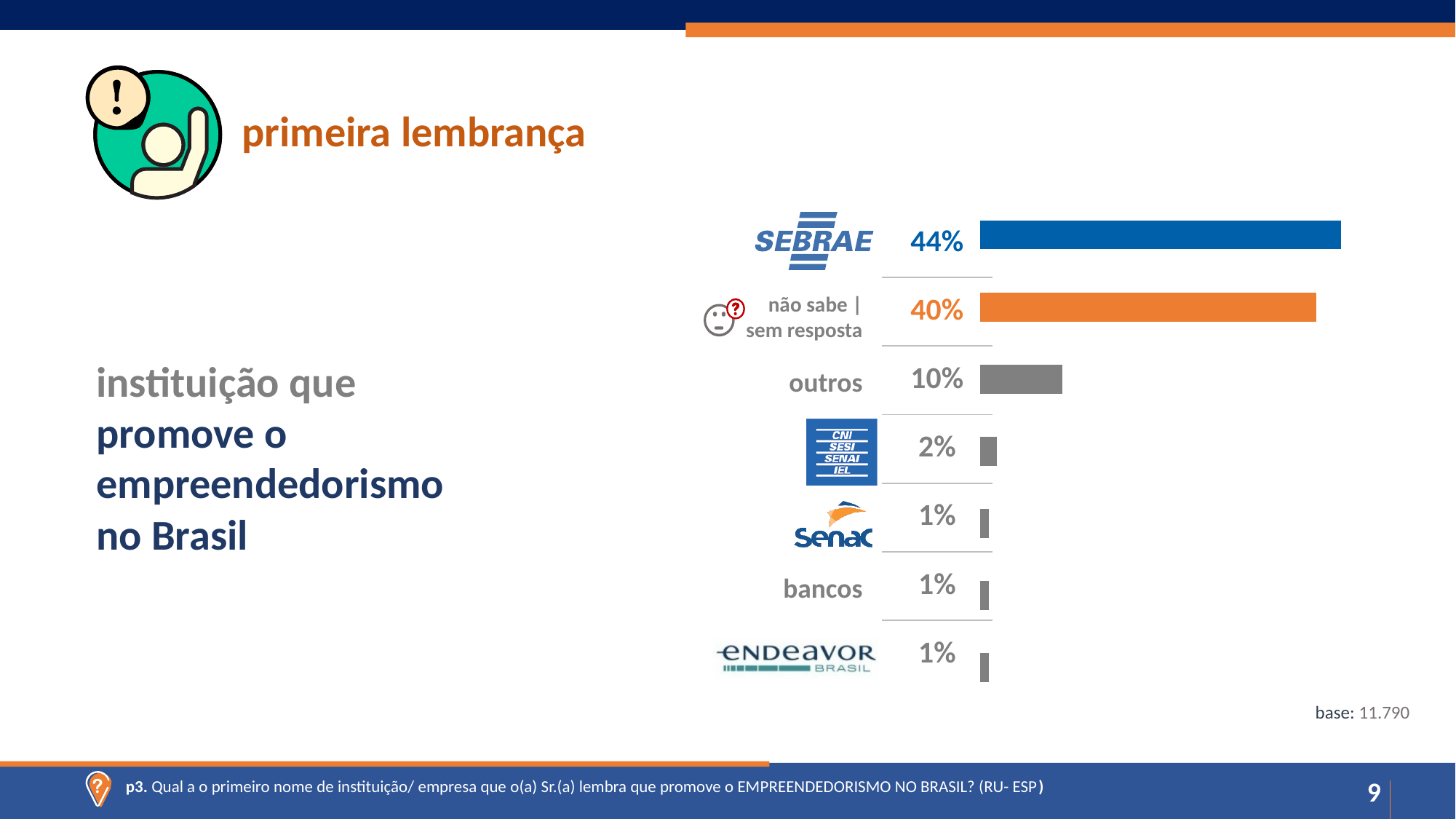
What is the value shown for the CNI/SESI/SENAI/IEL bar? 2% What percentage of respondents named SEBRAE as the institution that promotes entrepreneurship in Brazil? 44% Which category has the highest value in the chart? SEBRAE What kind of chart is shown on the slide? Bar chart What is the value shown for 'não sabe | sem resposta'? 40% What percentage is shown for 'bancos'? 1% Which is larger, the value for 'outros' or the value for Senac? outros What percentage is shown for 'outros'? 10% What is the difference between the SEBRAE value and the 'não sabe | sem resposta' value? 4 percentage points How many categories are shown in the chart? 7 What is the difference between the 'outros' value and the CNI/SESI/SENAI/IEL value? 8 percentage points What is the base (number of respondents) shown for the chart? 11.790